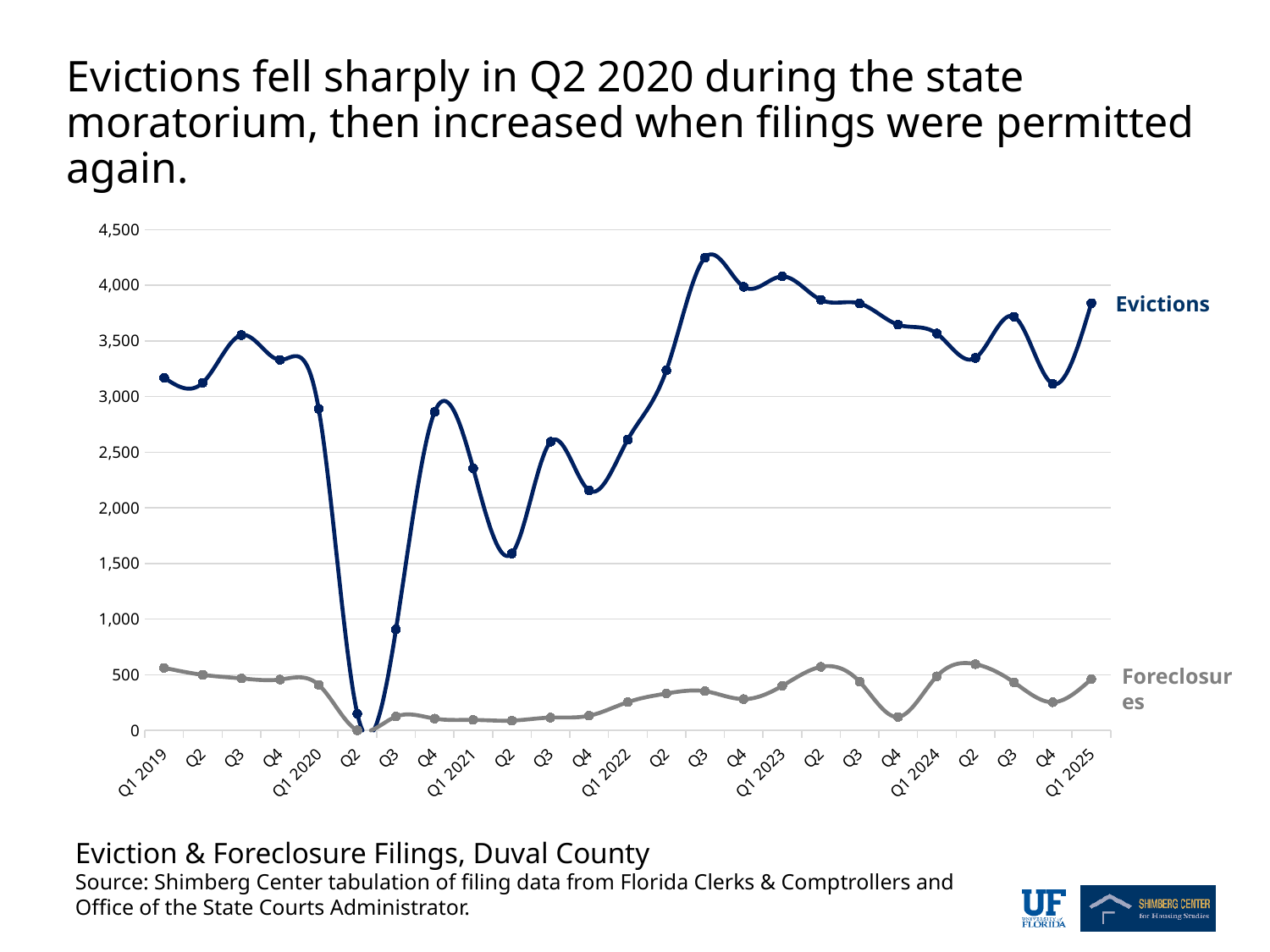
Is the value for Evictions in Q3 2021 greater or less than 4,000? less How many series does the chart show? 2 Which series has the larger value in Q1 2025, Evictions or Foreclosures? Evictions What is the title of the chart given below the plot? Eviction & Foreclosure Filings, Duval County How many quarterly data points are plotted for each series, from Q1 2019 to Q1 2025? 25 Do Evictions rise or fall between Q3 2019 and Q2 2020? fall Is the value for Evictions in Q2 2021 greater or less than 2,000? less Is the value for Evictions in Q2 2020 greater or less than 500? less In which quarter do Evictions reach their highest value? Q3 2022 In which quarter do Evictions reach their lowest value? Q2 2020 What kind of chart is shown on the slide? line chart